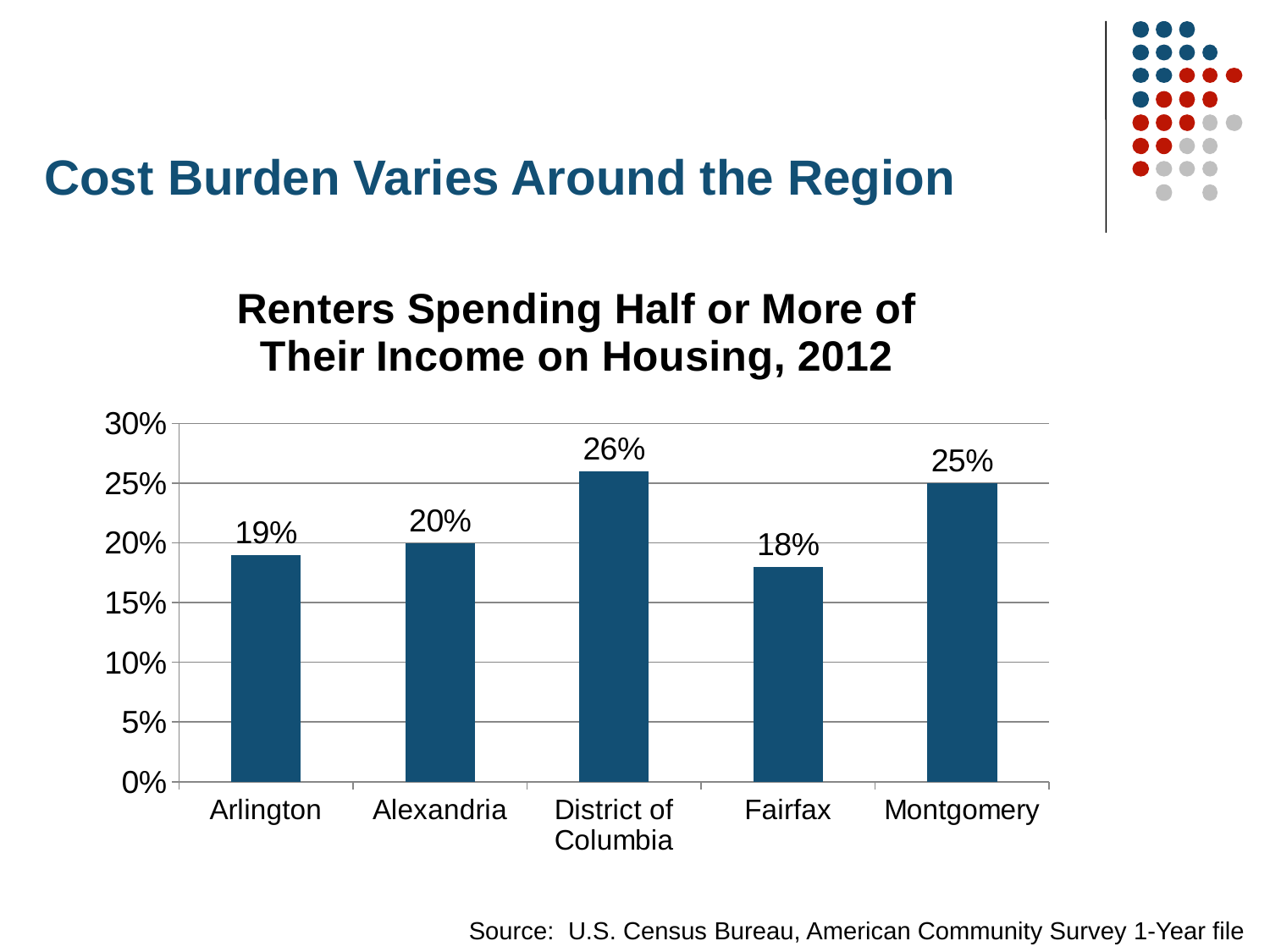
Which jurisdiction has the lowest value on the chart? Fairfax What is the difference between the values for the District of Columbia and Fairfax? 8% What is the title of the chart? Renters Spending Half or More of Their Income on Housing, 2012 What is the value shown for the District of Columbia? 26% Which jurisdiction has the highest share of renters spending half or more of their income on housing? District of Columbia What percentage of renters in Arlington spend half or more of their income on housing? 19% Which has a higher value, Alexandria or Montgomery? Montgomery What is the value shown for Montgomery? 25% Is the value for Fairfax greater or less than 20%? less How many jurisdictions are shown on the chart? 5 What is the difference between the values for Montgomery and Arlington? 6% What kind of chart is shown on the slide? Bar chart